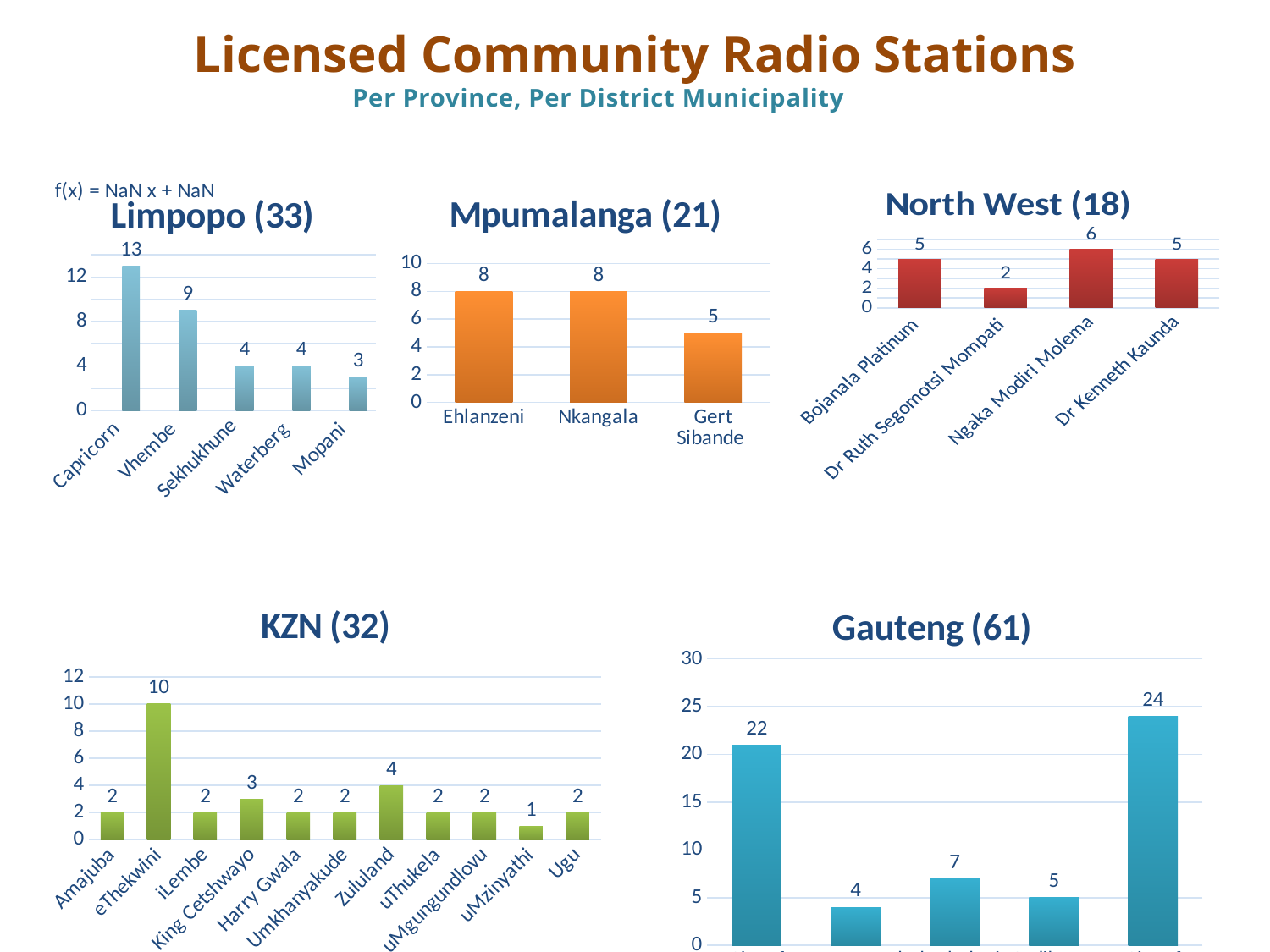
In the Gauteng (61) chart, how many bars are shown? 5 What type of chart is the Mpumalanga (21) chart? Bar chart In the KZN (32) chart, how many districts are shown? 11 In the Mpumalanga (21) chart, what is the difference between Ehlanzeni and Gert Sibande? 3 In the KZN (32) chart, which is larger, Zululand or King Cetshwayo? Zululand In the North West (18) chart, what is the value for Dr Ruth Segomotsi Mompati? 2 In the North West (18) chart, which district has the highest value? Ngaka Modiri Molema In the Mpumalanga (21) chart, what is the value for Gert Sibande? 5 In the Gauteng (61) chart, what is the highest value shown? 24 In the KZN (32) chart, which district has the highest value? eThekwini In the Limpopo (33) chart, what is the value for Capricorn? 13 In the Limpopo (33) chart, which district has the lowest value? Mopani